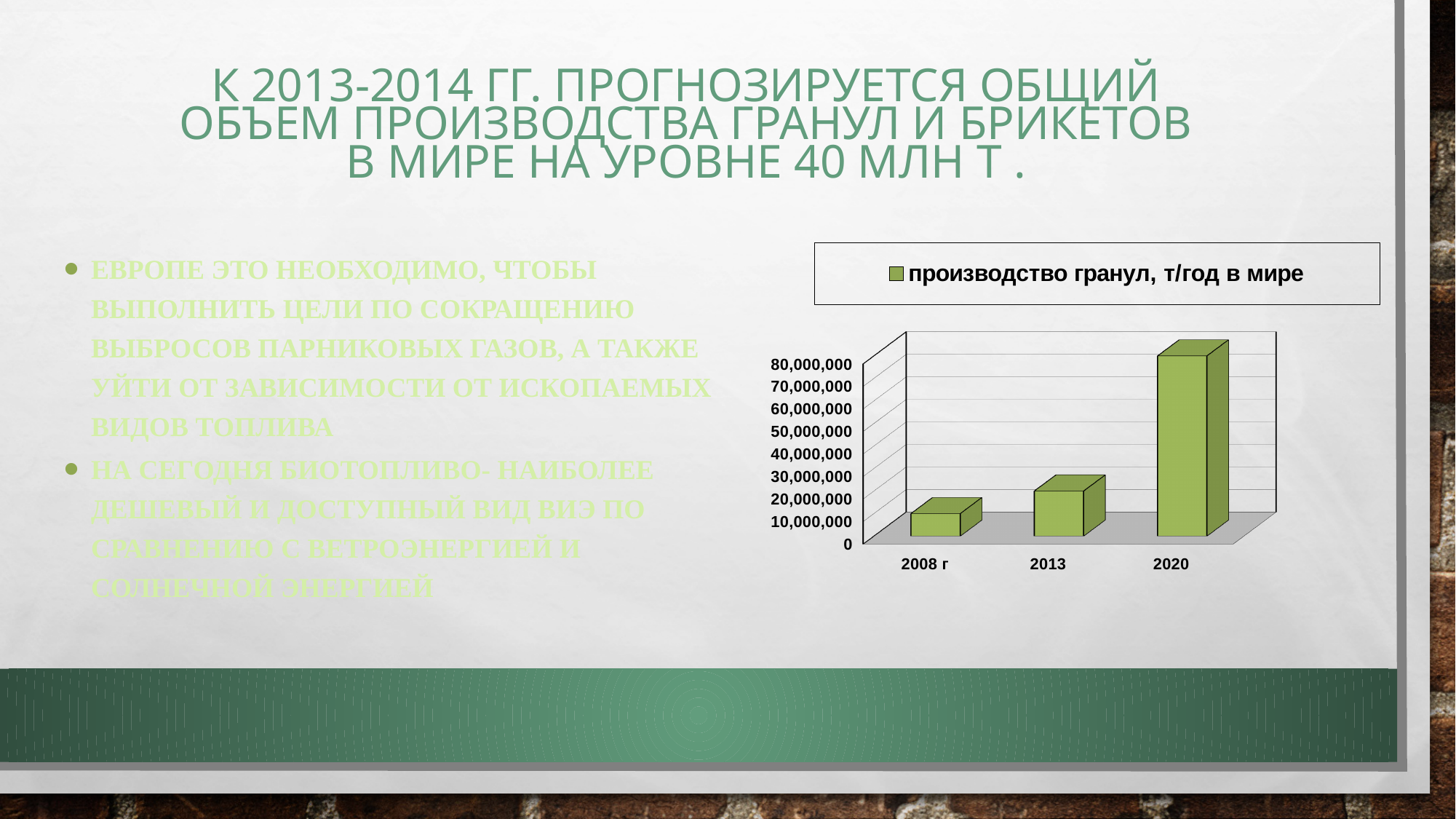
What is the series name shown in the chart legend? производство гранул, т/год в мире How many categories are shown on the x axis of the chart? 3 Is the value for 2008 г greater or less than 30,000,000? less Which category has the highest bar in the chart? 2020 Do the values rise or fall from 2008 г to 2020 along the x axis? rise Which is larger, the value for 2013 or the value for 2020? 2020 Which is larger, the value for 2008 г or the value for 2013? 2013 Which category has the lowest bar in the chart? 2008 г Is the value for 2013 greater or less than 40,000,000? less What kind of chart is shown on the slide? bar chart How many series does the chart legend list? 1 Is the value for 2020 greater or less than 60,000,000? greater